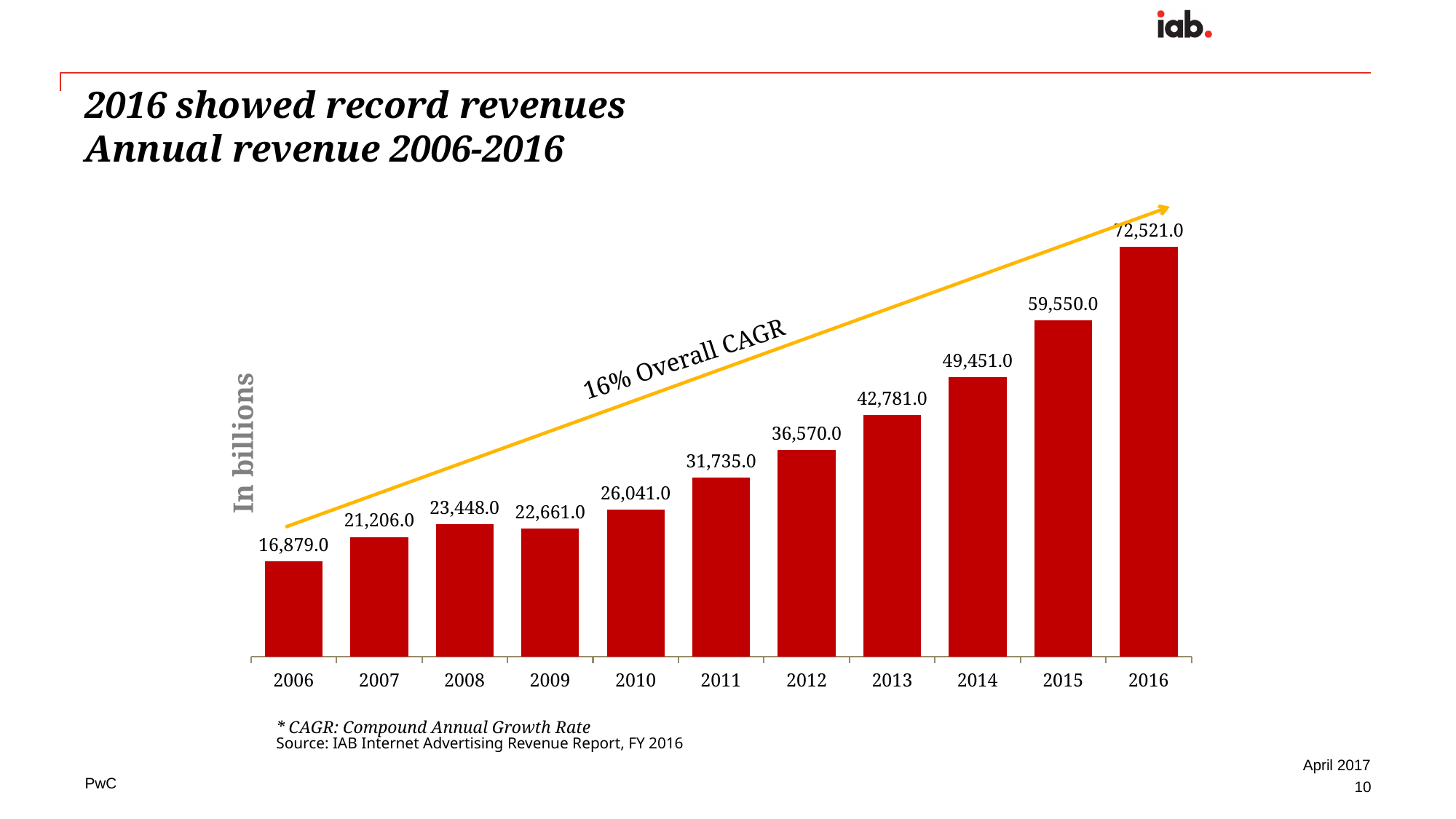
What overall CAGR is labelled on the arrow in the chart? 16% How many years are shown on the x axis of the chart? 11 What is the difference between the 2016 and 2015 revenue values? 12,971.0 What kind of chart is shown on the slide? Bar chart Which year had the highest annual revenue? 2016 What was the annual revenue in 2009? 22,661.0 Which year had higher revenue, 2008 or 2009? 2008 Which year had the lowest annual revenue? 2006 What was the annual revenue in 2012? 36,570.0 What is the difference between the 2008 and 2009 revenue values? 787.0 Do the revenue values generally rise or fall from 2006 to 2016? Rise What was the annual revenue in 2016? 72,521.0